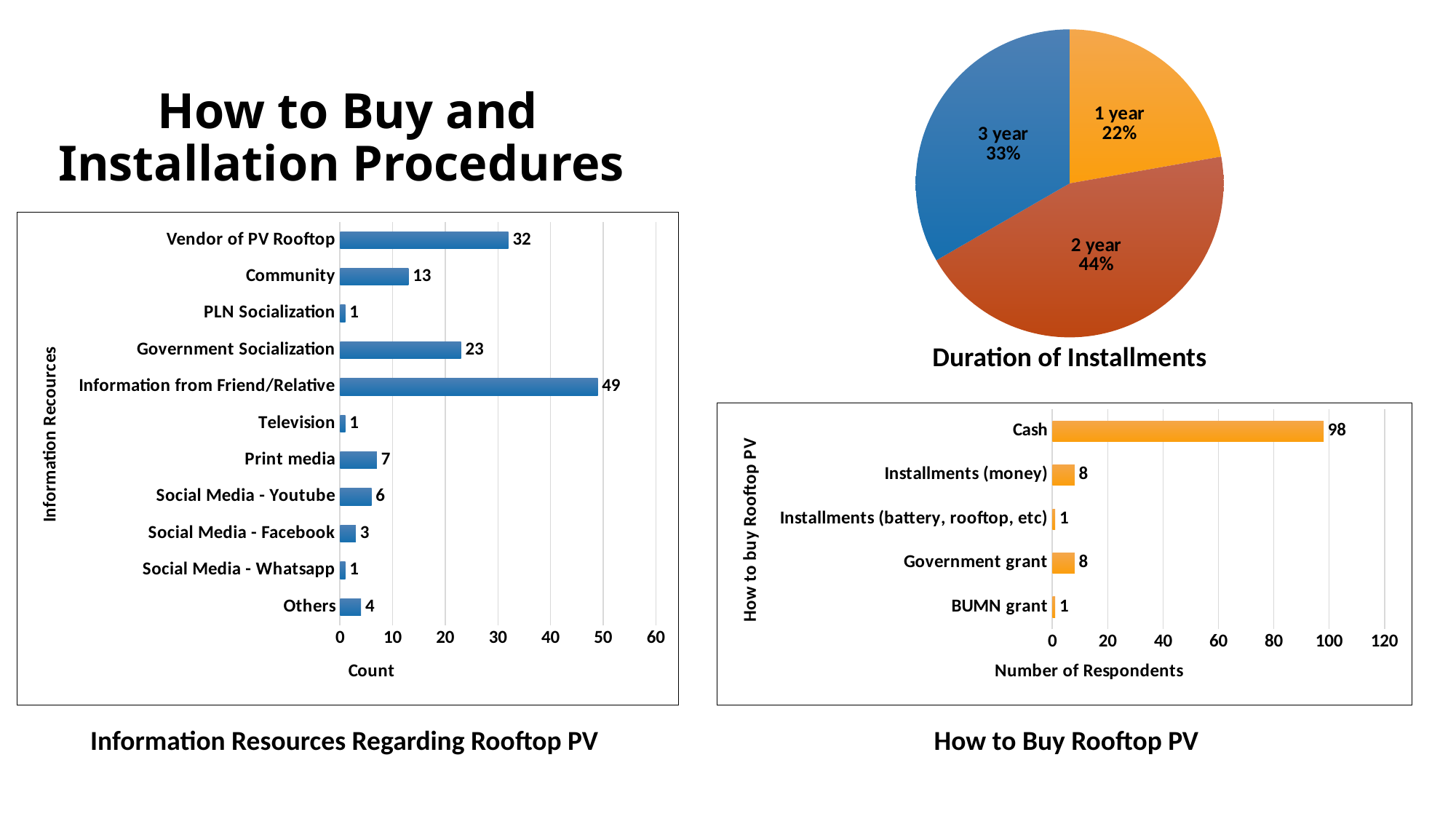
In the 'Information Resources Regarding Rooftop PV' chart, which has a larger count, Print media or Social Media - Youtube? Print media In the 'Duration of Installments' pie chart, which duration has the smallest share? 1 year In the 'Duration of Installments' pie chart, what share does 2 year have? 44% In the 'How to Buy Rooftop PV' chart, what is the number of respondents for Cash? 98 In the 'Information Resources Regarding Rooftop PV' chart, which information resource has the highest count? Information from Friend/Relative How many information resource categories are shown in the 'Information Resources Regarding Rooftop PV' chart? 11 In the 'Information Resources Regarding Rooftop PV' chart, what is the difference between the counts for Government Socialization and Community? 10 How many slices does the 'Duration of Installments' pie chart have? 3 What is the x-axis label of the 'How to Buy Rooftop PV' chart? Number of Respondents In the 'Information Resources Regarding Rooftop PV' chart, what is the count for Vendor of PV Rooftop? 32 What type of chart is 'Information Resources Regarding Rooftop PV'? Bar chart In the 'How to Buy Rooftop PV' chart, what is the difference between the number of respondents for Cash and Installments (money)? 90